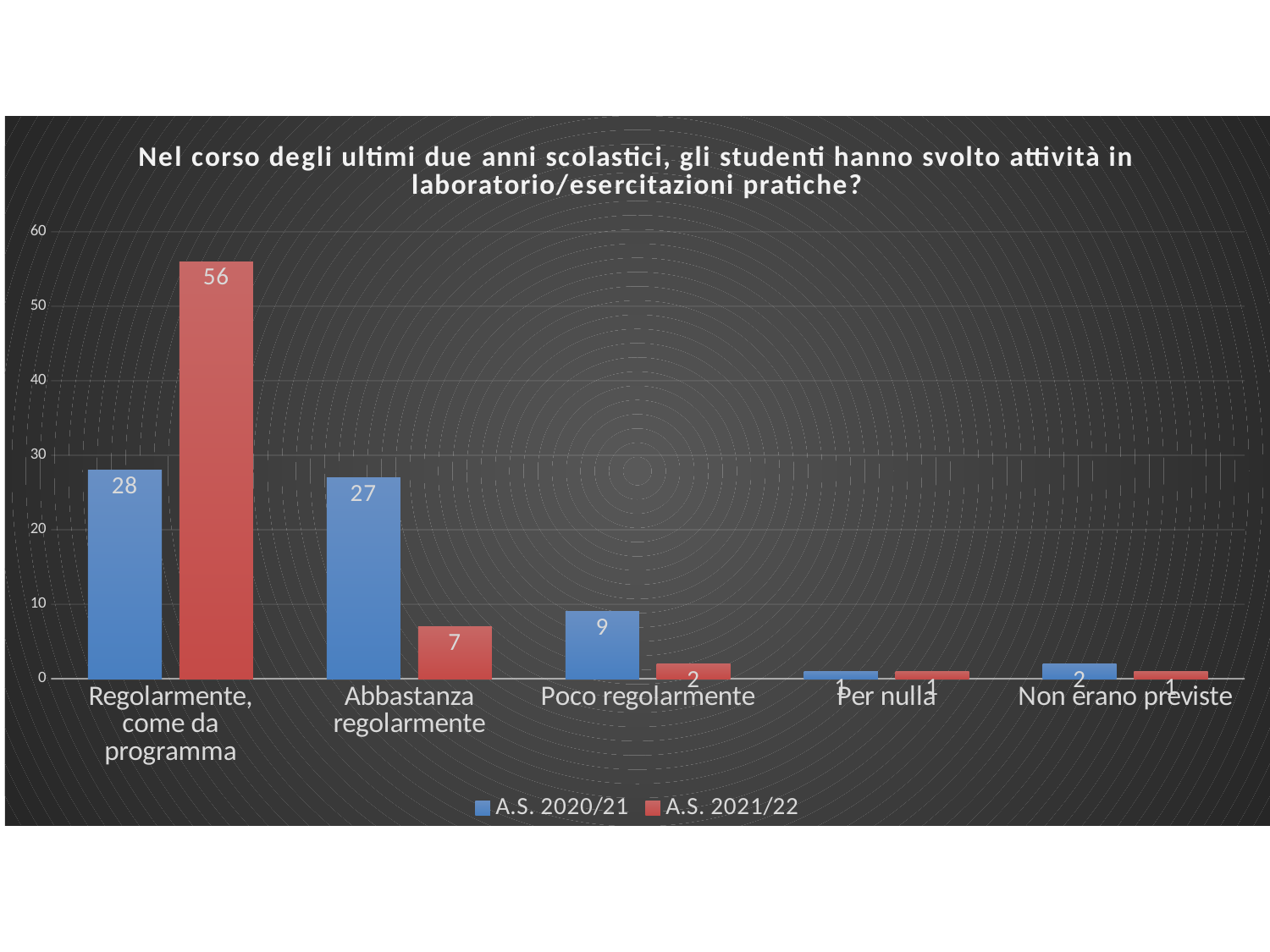
What is the value for "Abbastanza regolarmente" in the A.S. 2020/21 series? 27 How many series does the legend list? 2 What is the value for "Regolarmente, come da programma" in the A.S. 2021/22 series? 56 Which category has the lowest value in the A.S. 2020/21 series? Per nulla What is the difference between the A.S. 2021/22 and A.S. 2020/21 values for "Regolarmente, come da programma"? 28 How many categories are shown on the x axis? 5 For "Abbastanza regolarmente", which series has the larger value, A.S. 2020/21 or A.S. 2021/22? A.S. 2020/21 Is the A.S. 2021/22 value for "Regolarmente, come da programma" greater or less than 50? greater Which colour represents the A.S. 2021/22 series? red Which category has the highest value in the A.S. 2021/22 series? Regolarmente, come da programma What is the value for "Poco regolarmente" in the A.S. 2021/22 series? 2 What kind of chart is shown on the slide? bar chart